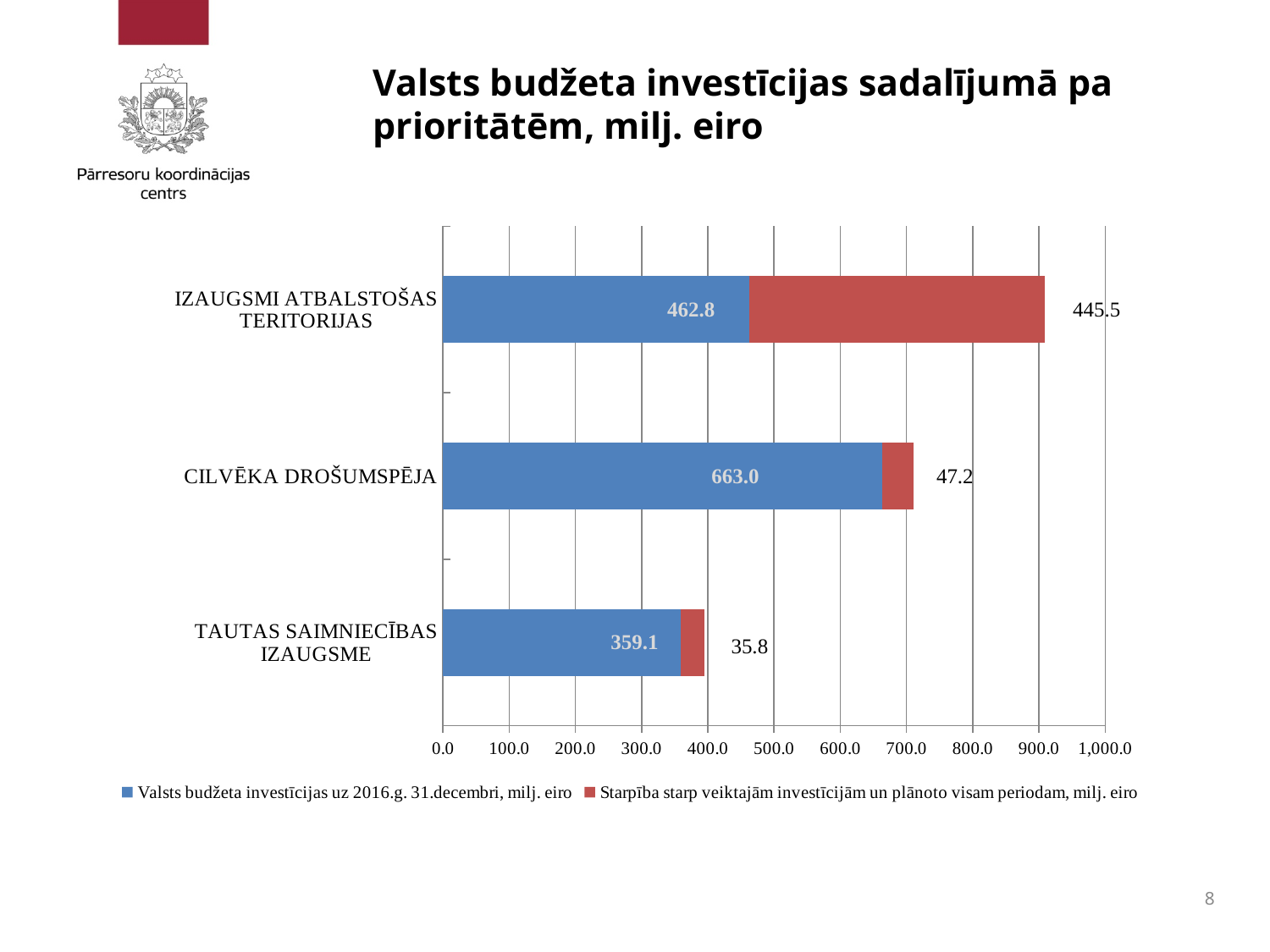
How many categories are shown in the chart? 3 Which category has the lowest value for 'Starpība starp veiktajām investīcijām un plānoto visam periodam, milj. eiro'? TAUTAS SAIMNIECĪBAS IZAUGSME What is the value of 'Starpība starp veiktajām investīcijām un plānoto visam periodam, milj. eiro' for IZAUGSMI ATBALSTOŠAS TERITORIJAS? 445.5 What is the value of 'Valsts budžeta investīcijas uz 2016.g. 31.decembri, milj. eiro' for CILVĒKA DROŠUMSPĒJA? 663.0 How many series does the legend list? 2 What is the total of the stacked bar for IZAUGSMI ATBALSTOŠAS TERITORIJAS? 908.3 What is the value of 'Starpība starp veiktajām investīcijām un plānoto visam periodam, milj. eiro' for TAUTAS SAIMNIECĪBAS IZAUGSME? 35.8 What kind of chart is shown on the slide? Stacked bar chart What is the total of the stacked bar for TAUTAS SAIMNIECĪBAS IZAUGSME? 394.9 Which category has the highest value for 'Valsts budžeta investīcijas uz 2016.g. 31.decembri, milj. eiro'? CILVĒKA DROŠUMSPĒJA What is the difference between the 'Valsts budžeta investīcijas uz 2016.g. 31.decembri' values for CILVĒKA DROŠUMSPĒJA and TAUTAS SAIMNIECĪBAS IZAUGSME? 303.9 Which is larger: the 'Starpība' value for CILVĒKA DROŠUMSPĒJA or for IZAUGSMI ATBALSTOŠAS TERITORIJAS? IZAUGSMI ATBALSTOŠAS TERITORIJAS